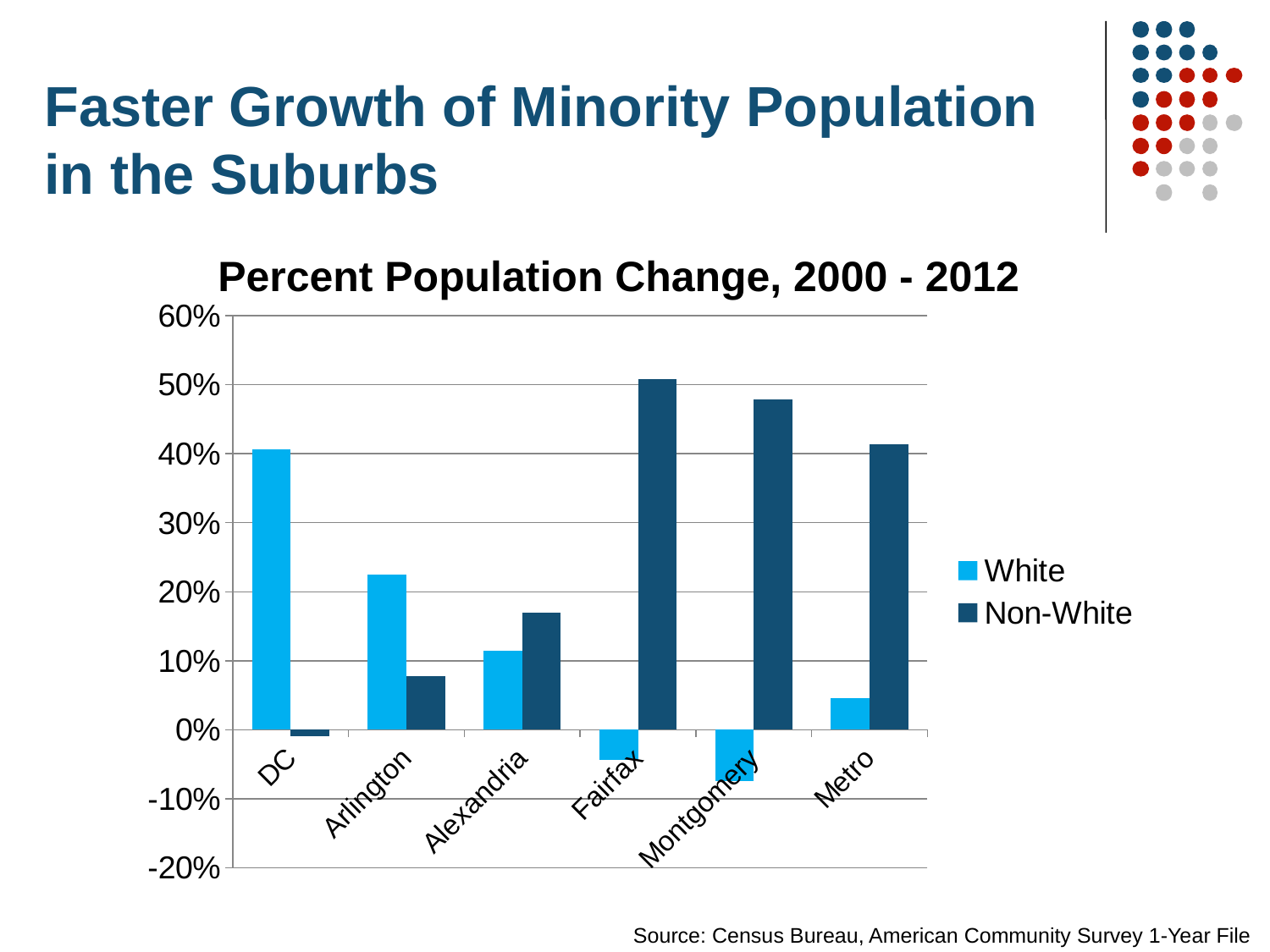
Which category has the highest value for the White series? DC How many series does the legend list? 2 Which category has the highest value for the Non-White series? Fairfax Is the Non-White value for Fairfax greater or less than 50%? greater What is the title of the chart? Percent Population Change, 2000 - 2012 How many categories are shown on the x axis? 6 Is the White value for Montgomery greater or less than 0%? less Which category has the lowest value for the White series? Montgomery Which category has the lowest value for the Non-White series? DC What type of chart is shown on the slide? bar chart Which is larger for Alexandria, the White value or the Non-White value? Non-White